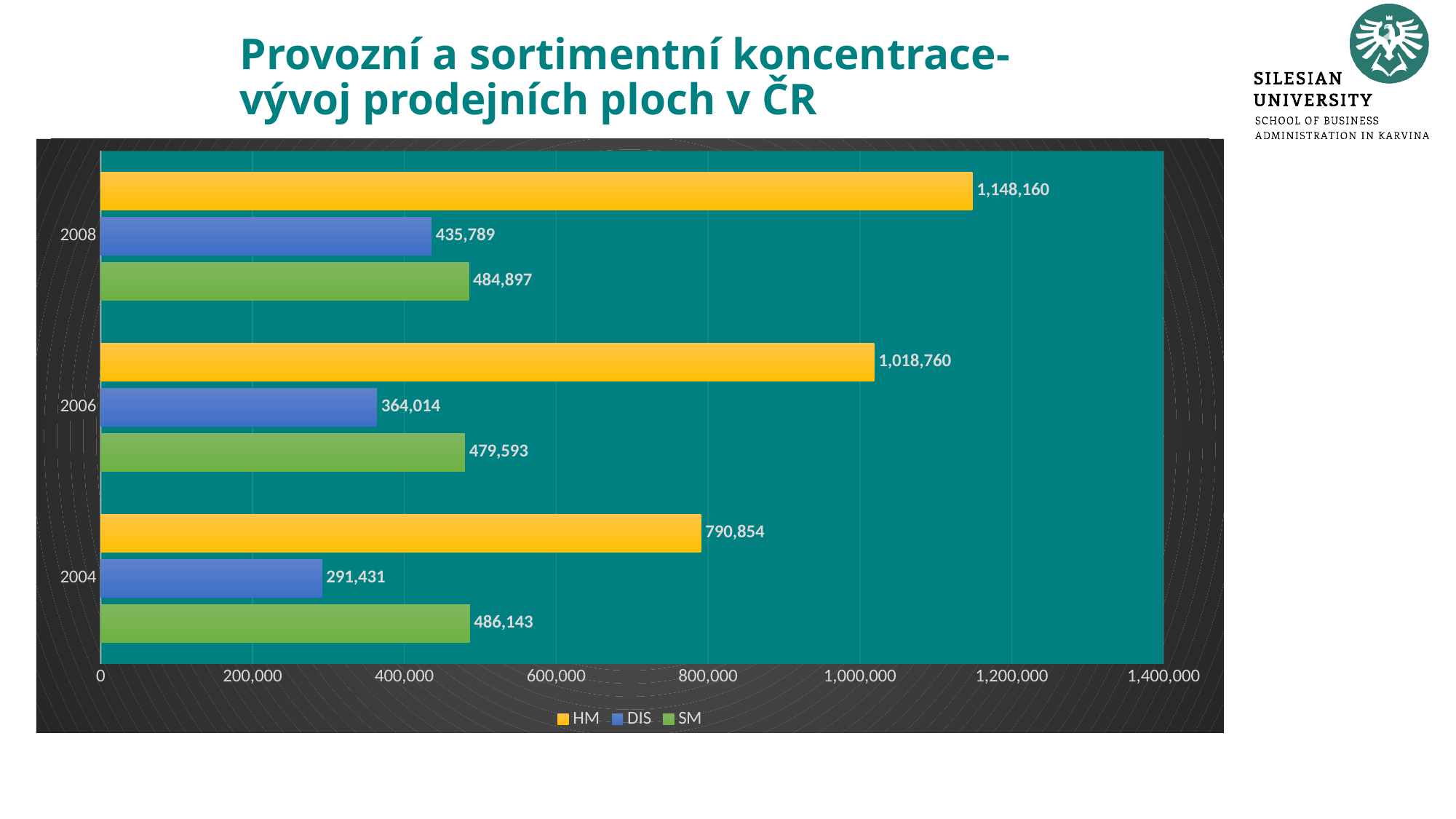
Is the value for HM in 2004 greater or less than 800,000? less What is the value for DIS in 2006? 364,014 What is the difference between the HM values for 2008 and 2006? 129,400 Which series has the highest value in 2008? HM Does the DIS value rise or fall from 2004 to 2008? rise What is the value for HM in 2008? 1,148,160 What is the value for SM in 2004? 486,143 How many years are shown on the chart? 3 How many series does the legend list? 3 Which series has the lowest value in 2004? DIS Which is larger in 2006, the DIS value or the SM value? SM What kind of chart is shown on the slide? bar chart